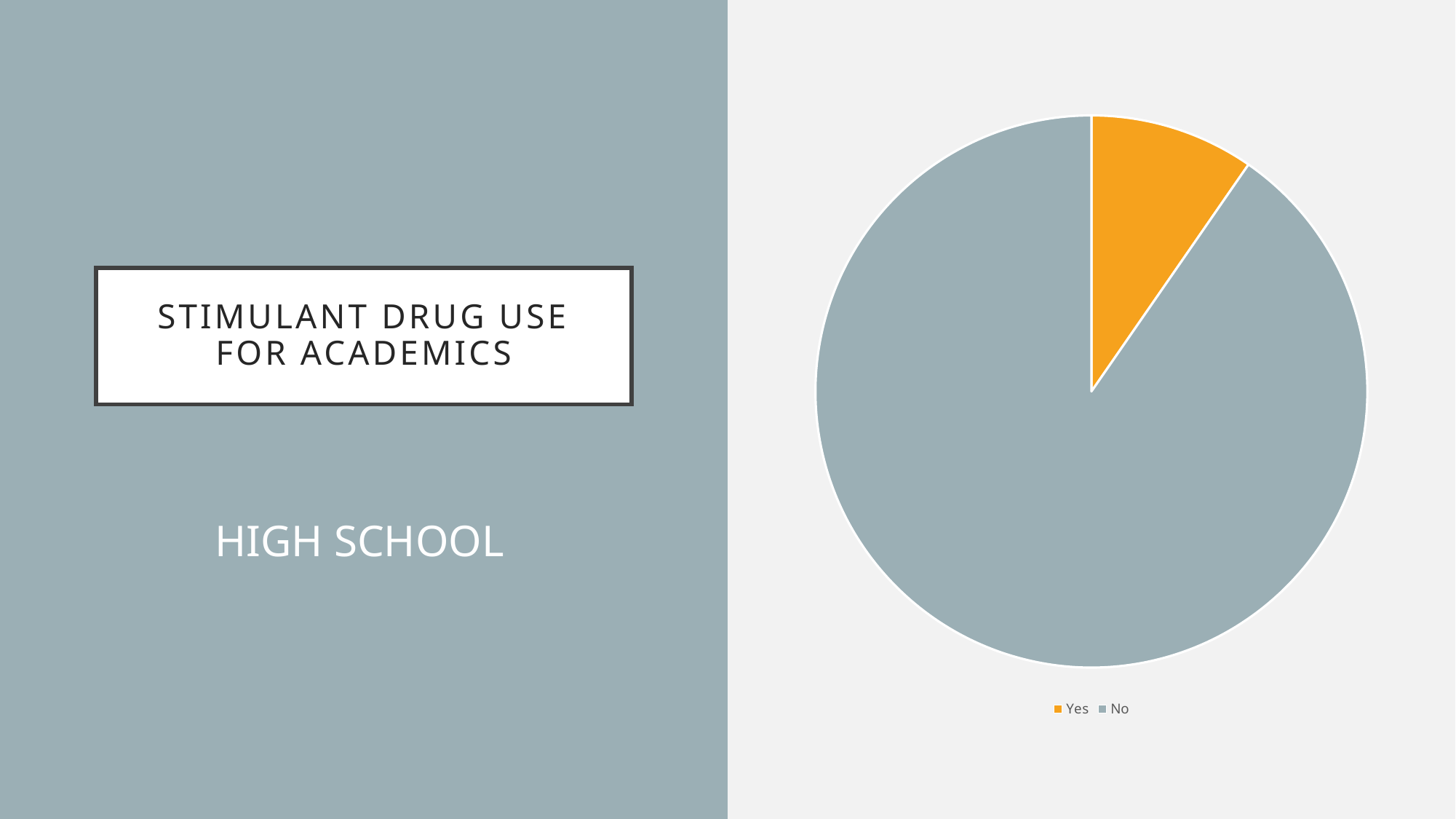
How many slices does the pie chart have? 2 Which slice of the pie chart is the smallest? Yes What colour is the Yes slice in the pie chart? orange What are the two legend entries of the pie chart? Yes and No Which slice of the pie chart is the largest? No What kind of chart is shown on the slide? pie chart How many entries does the legend of the pie chart list? 2 Which slice is larger in the pie chart, Yes or No? No